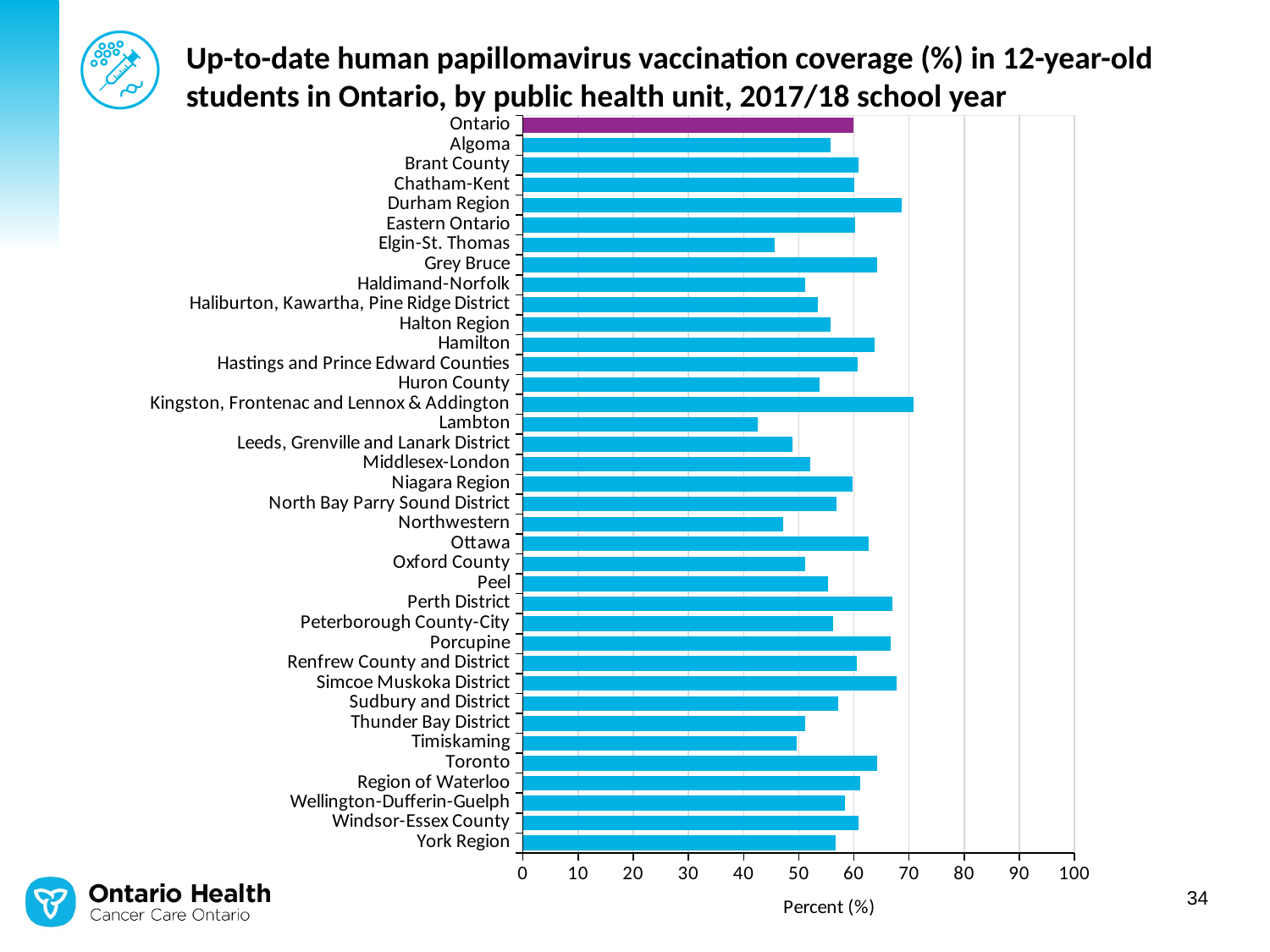
Is the value for Lambton greater or less than 50? less Which public health unit has the highest HPV vaccination coverage? Kingston, Frontenac and Lennox & Addington Is the value for Durham Region greater or less than 60? greater How many bars are plotted on the chart, including Ontario? 37 Is the value for Elgin-St. Thomas greater or less than 50? less Which public health unit has the lowest HPV vaccination coverage? Lambton What kind of chart is shown on the slide? bar chart Which has the higher coverage, Toronto or Lambton? Toronto Which has the higher coverage, Durham Region or Algoma? Durham Region What is the label of the horizontal axis? Percent (%)